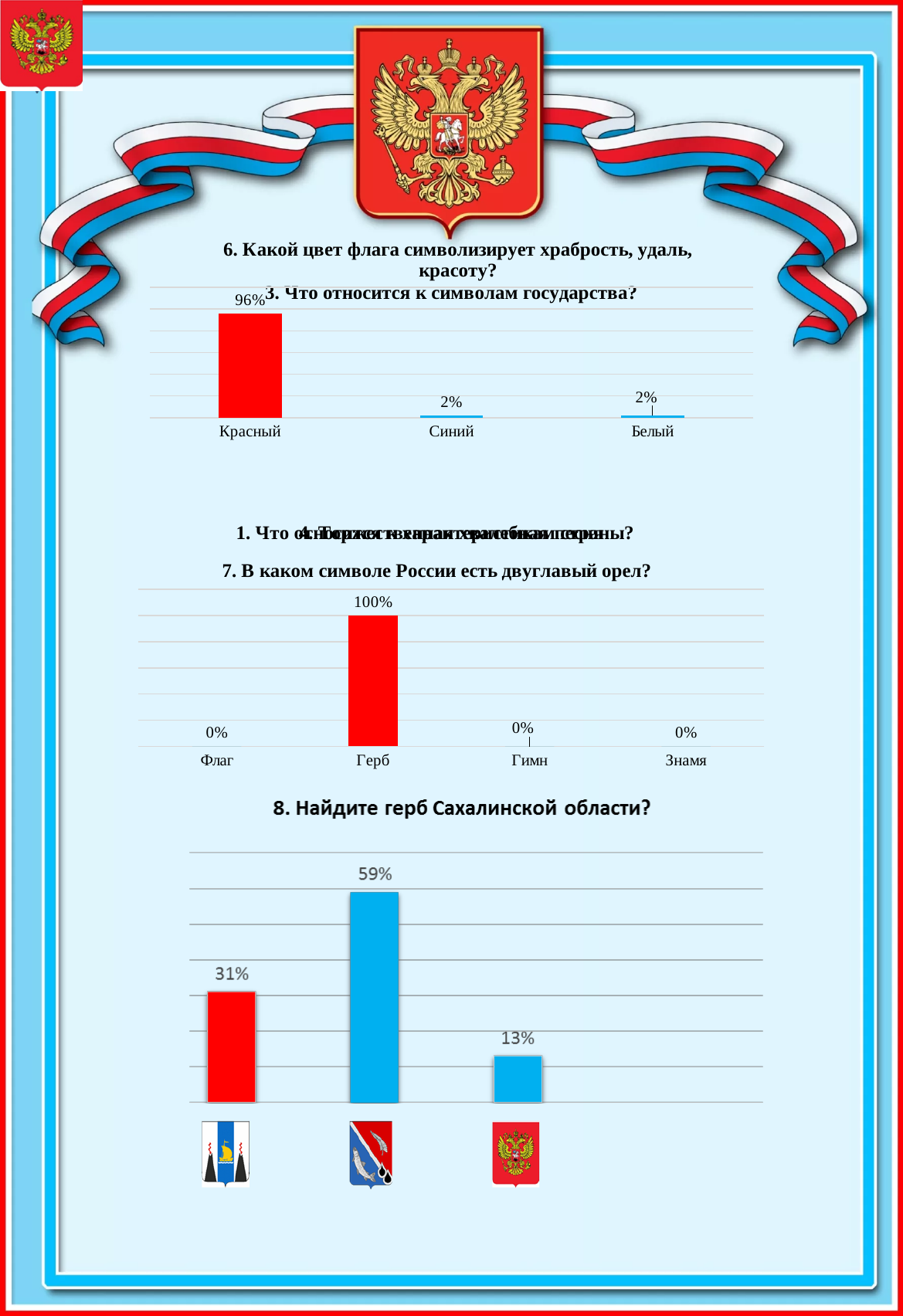
In the chart titled "7. В каком символе России есть двуглавый орел?", what is the value for Герб? 100% What kind of chart is the chart titled "8. Найдите герб Сахалинской области?"? bar chart In the chart titled "8. Найдите герб Сахалинской области?", what is the value of the second (middle) bar? 59% In the chart titled "6. Какой цвет флага символизирует храбрость, удаль, красоту?", which category has the highest value? Красный In the chart titled "6. Какой цвет флага символизирует храбрость, удаль, красоту?", what is the difference between the values for Красный and Белый? 94% In the chart titled "7. В каком символе России есть двуглавый орел?", which is larger, the value for Флаг or the value for Герб? Герб In the chart titled "6. Какой цвет флага символизирует храбрость, удаль, красоту?", how many categories are shown on the x axis? 3 In the chart titled "8. Найдите герб Сахалинской области?", what is the difference between the first bar and the third bar? 18% In the chart titled "6. Какой цвет флага символизирует храбрость, удаль, красоту?", what is the value for Синий? 2% In the chart titled "6. Какой цвет флага символизирует храбрость, удаль, красоту?", what is the value for Красный? 96% In the chart titled "7. В каком символе России есть двуглавый орел?", how many categories are shown on the x axis? 4 In the chart titled "7. В каком символе России есть двуглавый орел?", what is the value for Гимн? 0%